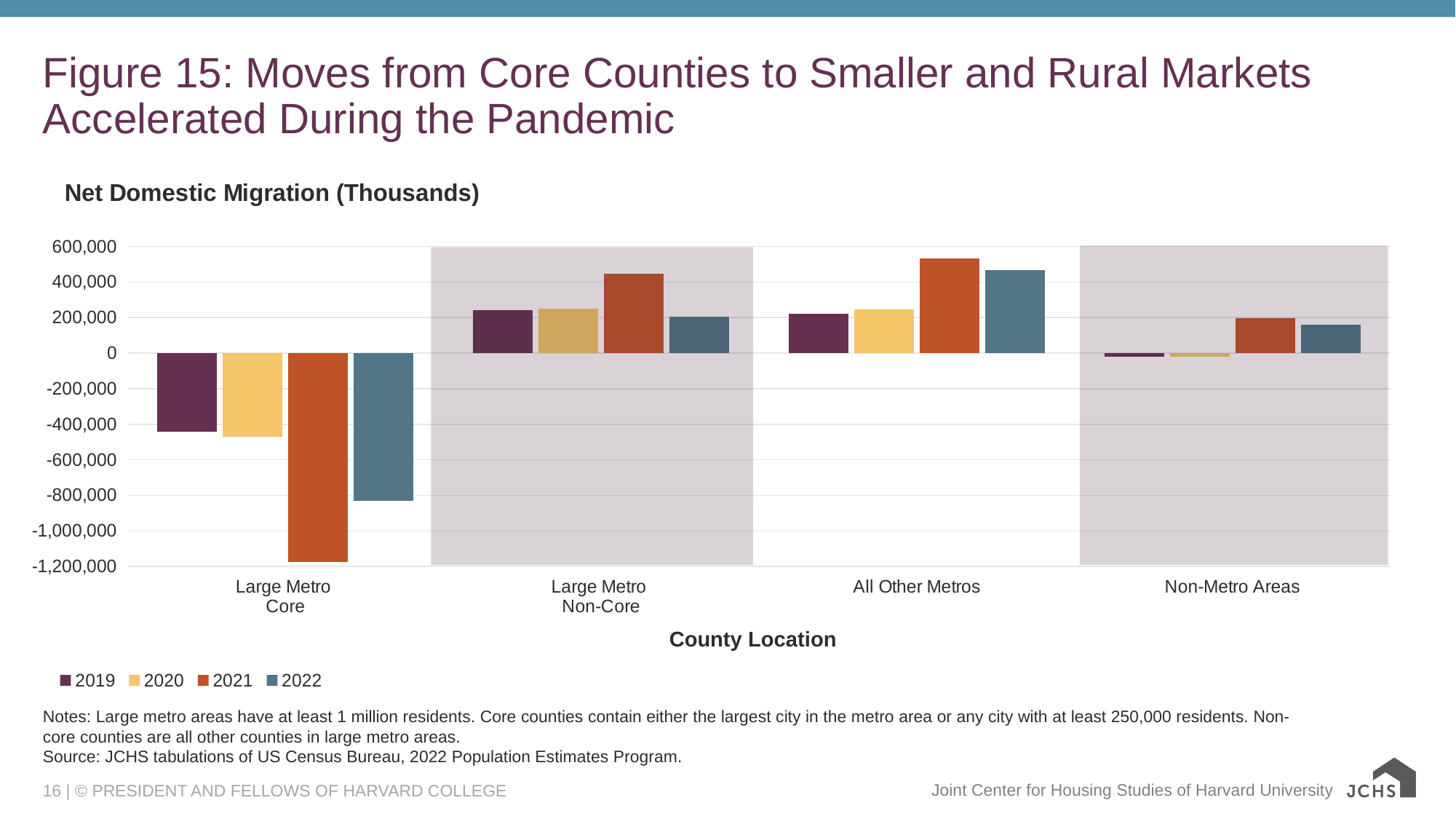
Which county location has the lowest value for 2021? Large Metro Core For All Other Metros, which year has the highest value? 2021 What is the title of the chart's vertical axis? Net Domestic Migration (Thousands) Is the value for Large Metro Core in 2019 greater or less than -400,000? less How many county location categories are shown on the x axis? 4 What kind of chart is shown on the slide? bar chart For Large Metro Core, which is lower: the value for 2021 or the value for 2022? 2021 How many series does the legend list? 4 What is the title of the chart's horizontal axis? County Location Is the value for All Other Metros in 2021 greater or less than 400,000? greater Is the value for Large Metro Core in 2021 greater or less than -1,000,000? less For Large Metro Non-Core, which is larger: the value for 2021 or the value for 2022? 2021